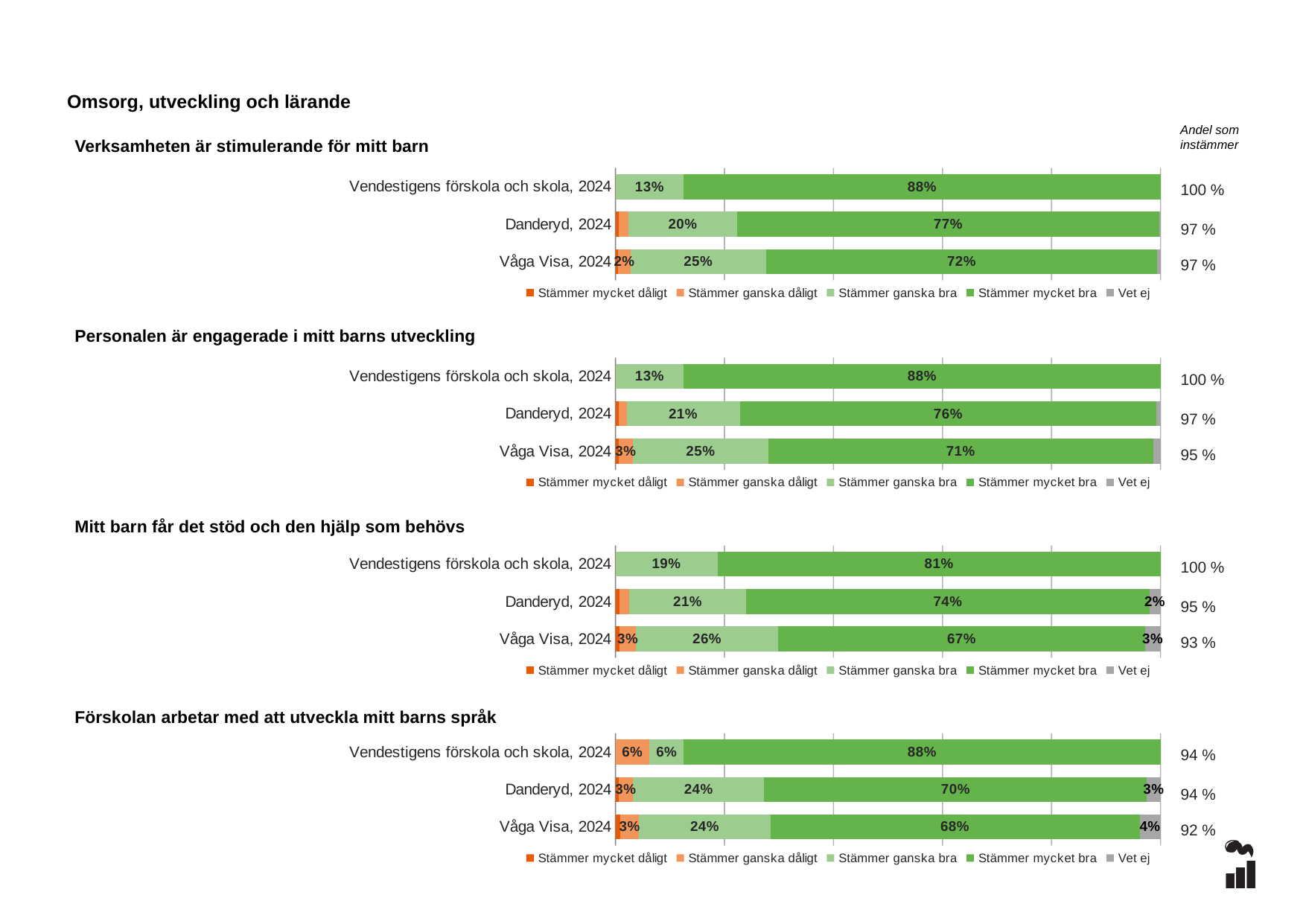
In the chart 'Förskolan arbetar med att utveckla mitt barns språk', which is larger: the 'Stämmer mycket bra' value for Danderyd, 2024 or for Våga Visa, 2024? Danderyd, 2024 What kind of chart is used for 'Personalen är engagerade i mitt barns utveckling'? Stacked bar chart In the chart 'Förskolan arbetar med att utveckla mitt barns språk', what percentage for Vendestigens förskola och skola, 2024 answered 'Stämmer ganska dåligt'? 6% In the chart 'Förskolan arbetar med att utveckla mitt barns språk', which category has the highest 'Stämmer mycket bra' value? Vendestigens förskola och skola, 2024 How many categories (bars) are shown in the chart 'Verksamheten är stimulerande för mitt barn'? 3 How many series does the legend list in the chart 'Mitt barn får det stöd och den hjälp som behövs'? 5 In the chart 'Verksamheten är stimulerande för mitt barn', what percentage of respondents for Vendestigens förskola och skola, 2024 answered 'Stämmer mycket bra'? 88% In the chart 'Personalen är engagerade i mitt barns utveckling', what percentage for Våga Visa, 2024 answered 'Stämmer ganska bra'? 25% In the chart 'Verksamheten är stimulerande för mitt barn', what is the 'Andel som instämmer' value for Danderyd, 2024? 97 % In the chart 'Mitt barn får det stöd och den hjälp som behövs', what percentage for Våga Visa, 2024 answered 'Vet ej'? 3% In the chart 'Personalen är engagerade i mitt barns utveckling', which category has the lowest 'Andel som instämmer'? Våga Visa, 2024 In the chart 'Mitt barn får det stöd och den hjälp som behövs', what is the difference between the 'Stämmer mycket bra' values for Vendestigens förskola och skola, 2024 and Danderyd, 2024? 7 percentage points